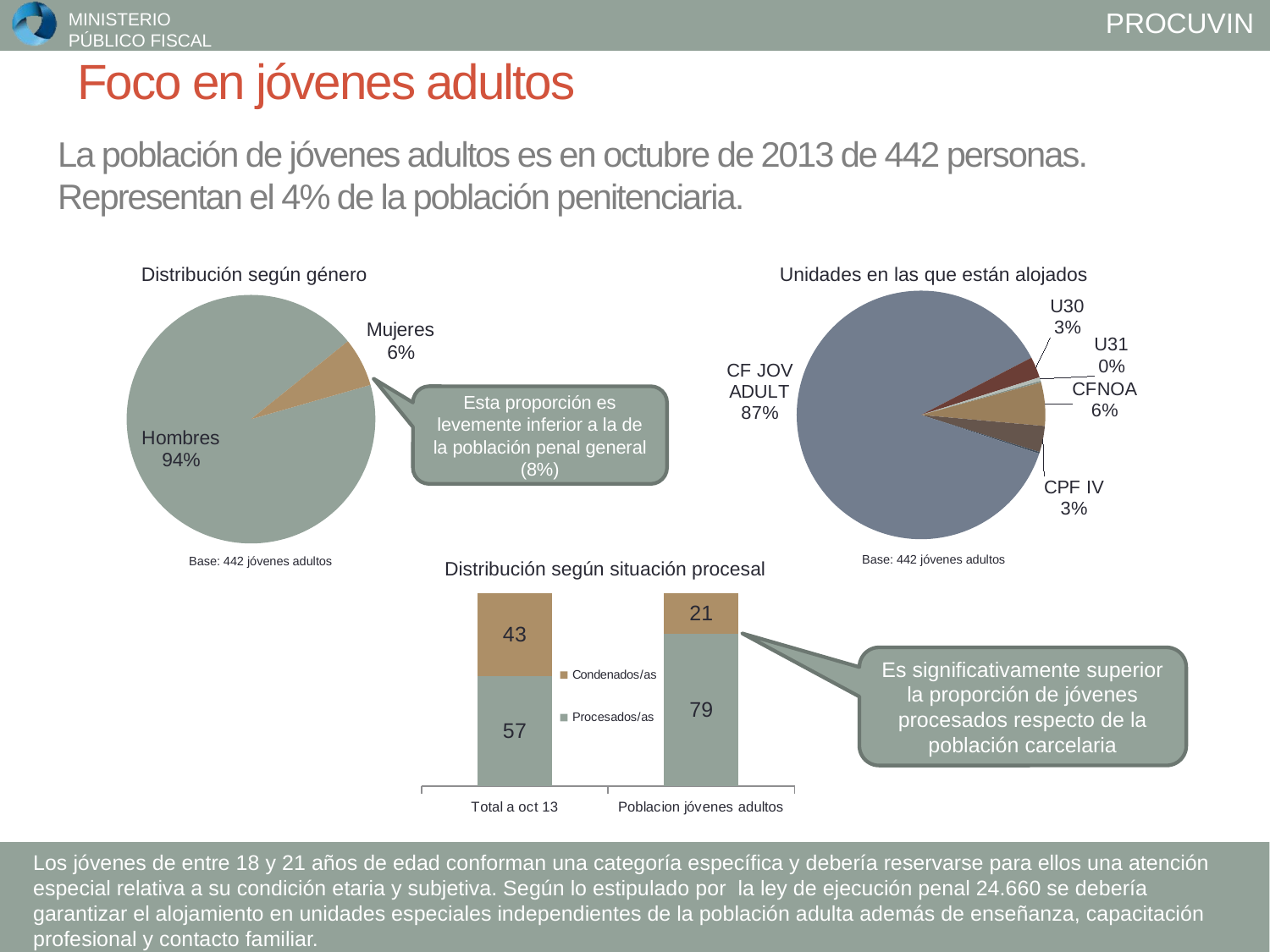
In the 'Unidades en las que están alojados' chart, what share is CF JOV ADULT? 87% In the 'Distribución según situación procesal' chart, what is the difference between the Procesados/as values for Poblacion jóvenes adultos and Total a oct 13? 22 How many slices are labelled in the 'Unidades en las que están alojados' chart? 5 In the 'Unidades en las que están alojados' chart, what share is CFNOA? 6% How many series does the legend of the 'Distribución según situación procesal' chart list? 2 In the 'Distribución según género' chart, what share of the pie is Hombres? 94% What kind of chart is 'Distribución según género'? Pie chart In the 'Distribución según situación procesal' chart, what is the Procesados/as value for Poblacion jóvenes adultos? 79 In the 'Distribución según situación procesal' chart, what is the Condenados/as value for Total a oct 13? 43 In the 'Unidades en las que están alojados' chart, which unit has the largest share? CF JOV ADULT